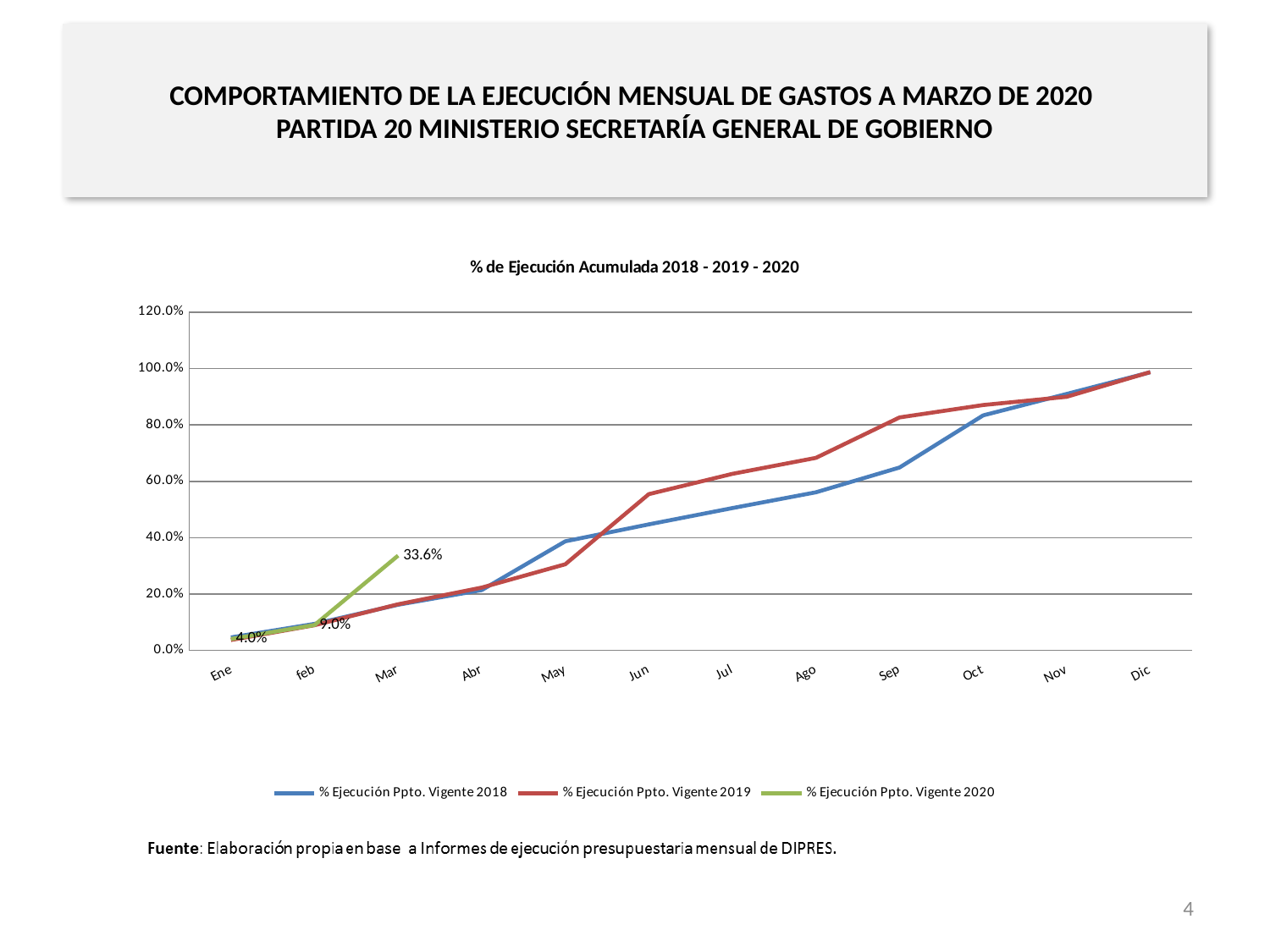
How many series does the legend list? 3 By how much did % Ejecución Ppto. Vigente 2020 increase from Feb to Mar? 24.6% Is the value for % Ejecución Ppto. Vigente 2018 in Sep greater or less than 80.0%? less How many months are shown along the x axis? 12 What is the value of % Ejecución Ppto. Vigente 2020 in Feb? 9.0% Does the % Ejecución Ppto. Vigente 2018 line rise or fall from Ene to Dic? Rise Is the value for % Ejecución Ppto. Vigente 2019 in Jun greater or less than 40.0%? greater What is the title of the chart? % de Ejecución Acumulada 2018 - 2019 - 2020 What is the value of % Ejecución Ppto. Vigente 2020 in Ene? 4.0% In Sep, which series is higher: % Ejecución Ppto. Vigente 2018 or % Ejecución Ppto. Vigente 2019? % Ejecución Ppto. Vigente 2019 What kind of chart is shown on the slide? Line chart What is the value of % Ejecución Ppto. Vigente 2020 in Mar? 33.6%